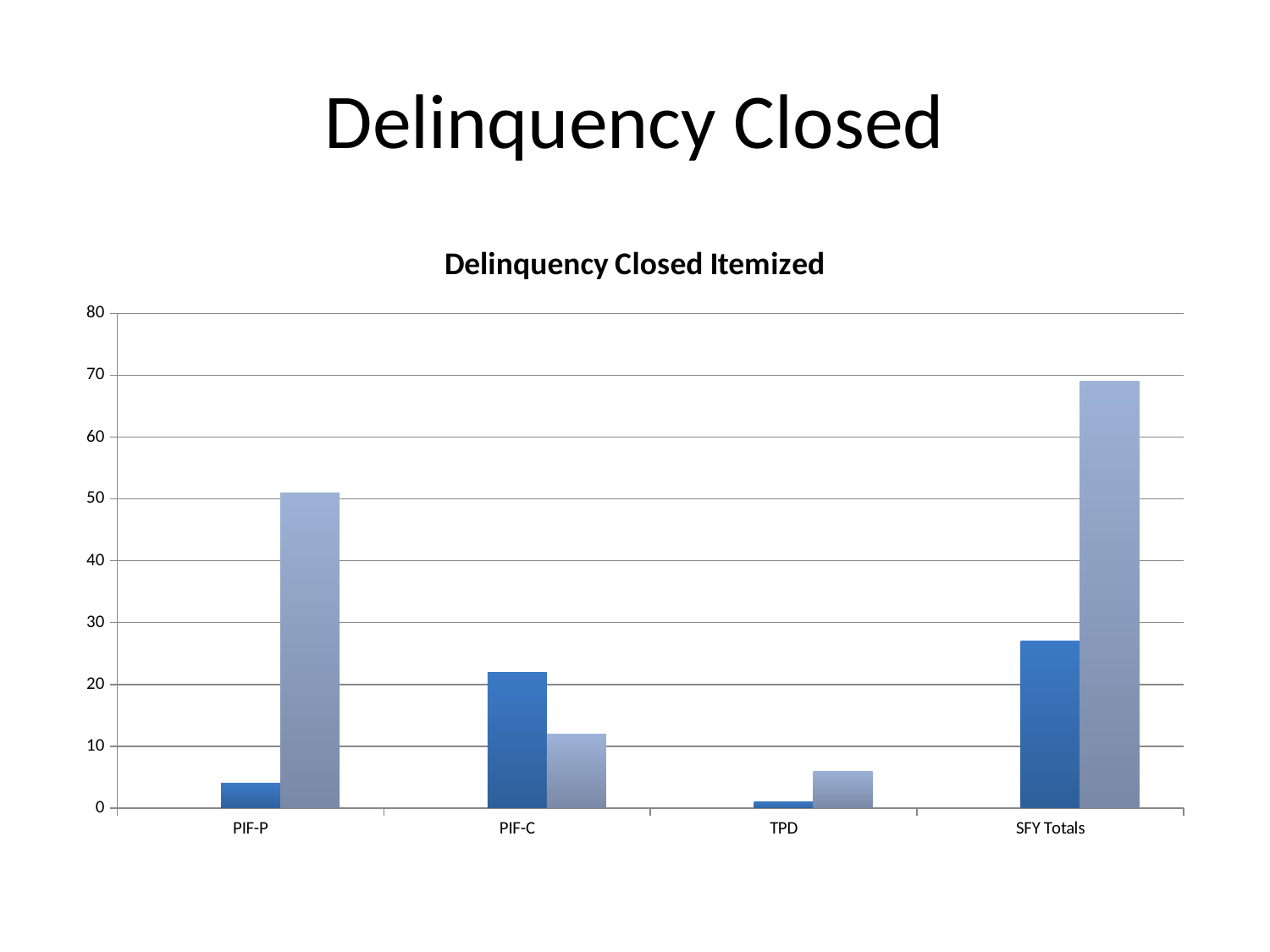
Is the value of the light blue bar for SFY Totals greater or less than 60? greater Is the value of the light blue bar for TPD greater or less than 10? less What is the title of the chart? Delinquency Closed Itemized Is the value of the dark blue bar for PIF-C greater or less than 30? less What kind of chart is shown on the slide? bar chart For PIF-C, which bar is larger, the dark blue bar or the light blue bar? the dark blue bar Which category has the shortest dark blue bar? TPD Which category has the tallest light blue bar? SFY Totals For PIF-P, which bar is larger, the dark blue bar or the light blue bar? the light blue bar How many categories are shown on the x axis of the chart? 4